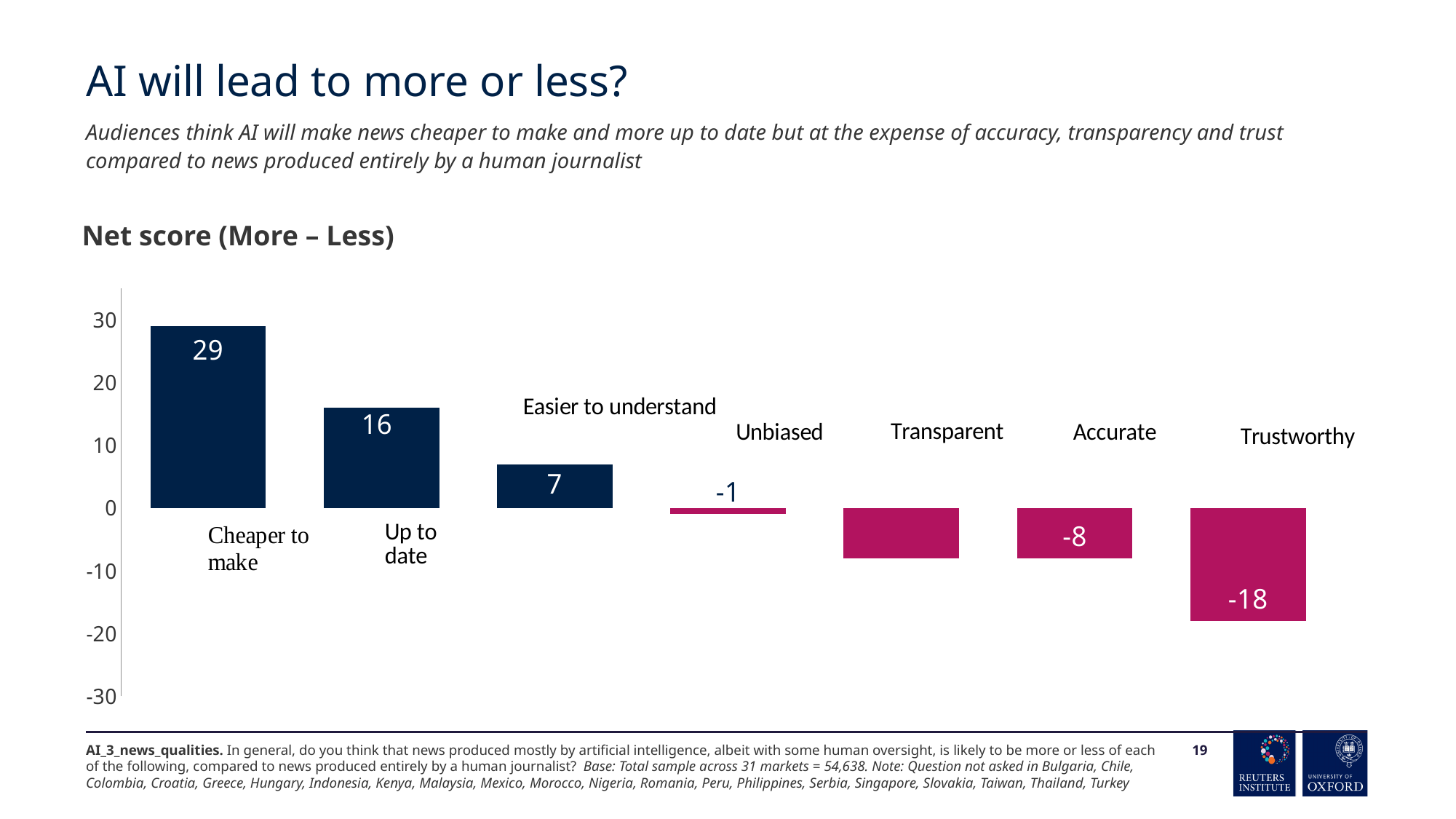
What is the net score for Cheaper to make? 29 What is the net score for Accurate? -8 What is the net score for Up to date? 16 Which category has the lowest net score? Trustworthy Is the net score for Transparent greater or less than -10? greater How many categories are shown in the chart? 7 Which category has the highest net score? Cheaper to make Which has a higher net score, Up to date or Easier to understand? Up to date What is the net score for Easier to understand? 7 What type of chart is shown on the slide? Bar chart What is the net score for Trustworthy? -18 What is the difference between the net scores for Cheaper to make and Up to date? 13